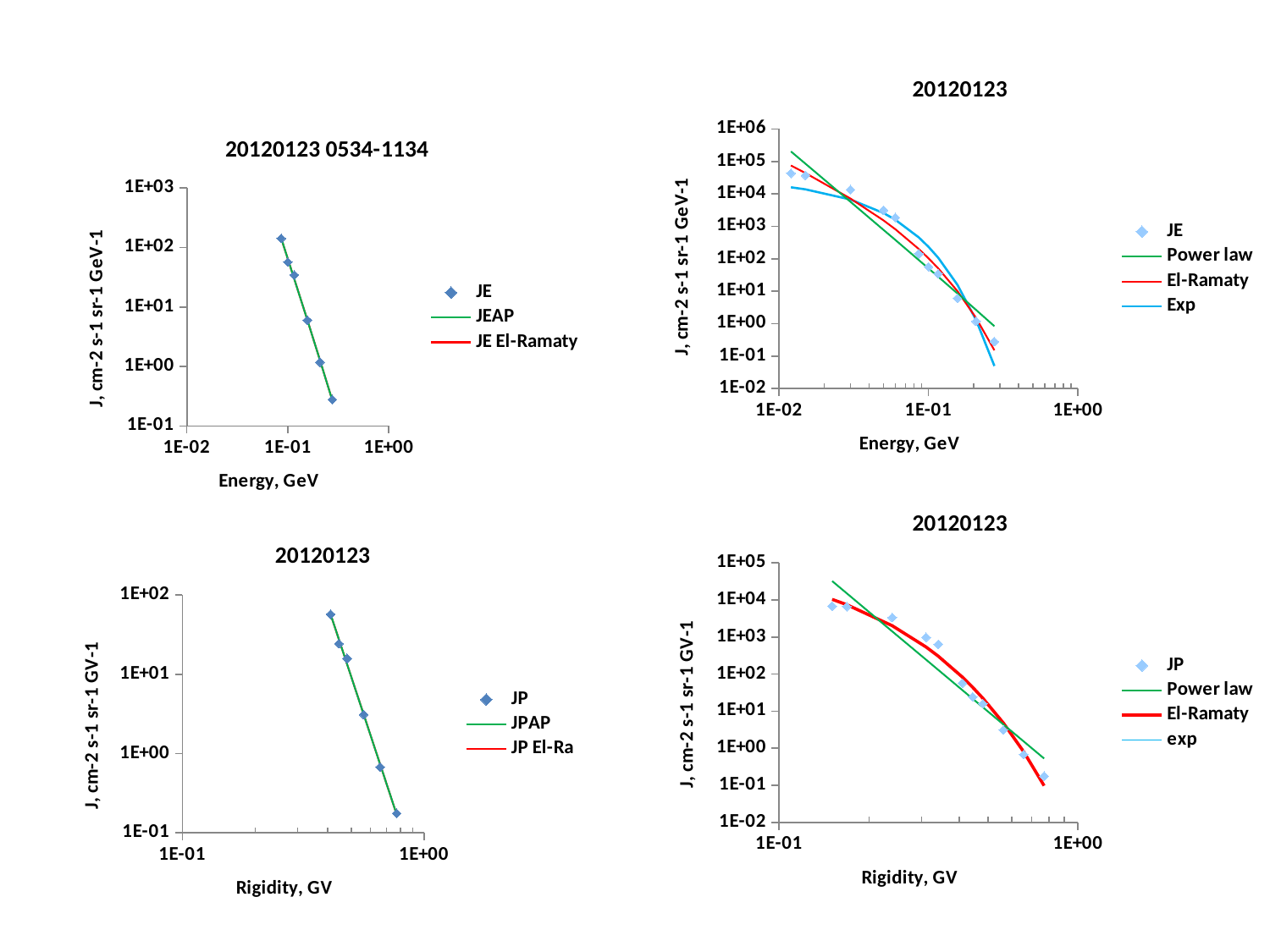
In the bottom-right chart (Rigidity, GV on the x axis), is the lowest JP value greater or less than 1E+00? less In the top-right chart (Energy, GeV on the x axis), is the highest JE value greater or less than 1E+04? greater In the bottom-left chart (Rigidity, GV on the x axis), do the JP values rise or fall as rigidity increases? fall How many series does the legend list in the bottom-right chart (Rigidity, GV on the x axis)? 4 How many series does the legend list in the top-left chart titled "20120123 0534-1134"? 3 What is the x-axis label of the bottom-left chart? Rigidity, GV In the bottom-left chart (Rigidity, GV on the x axis), is the highest JP value greater or less than 1E+02? less What are the legend entries of the bottom-left chart? JP, JPAP, JP El-Ra How many series does the legend list in the top-right chart (Energy, GeV on the x axis)? 4 What kind of chart is the top-left chart titled "20120123 0534-1134"? scatter chart with fitted lines In the top-left chart titled "20120123 0534-1134", do the JE values rise or fall as energy increases? fall